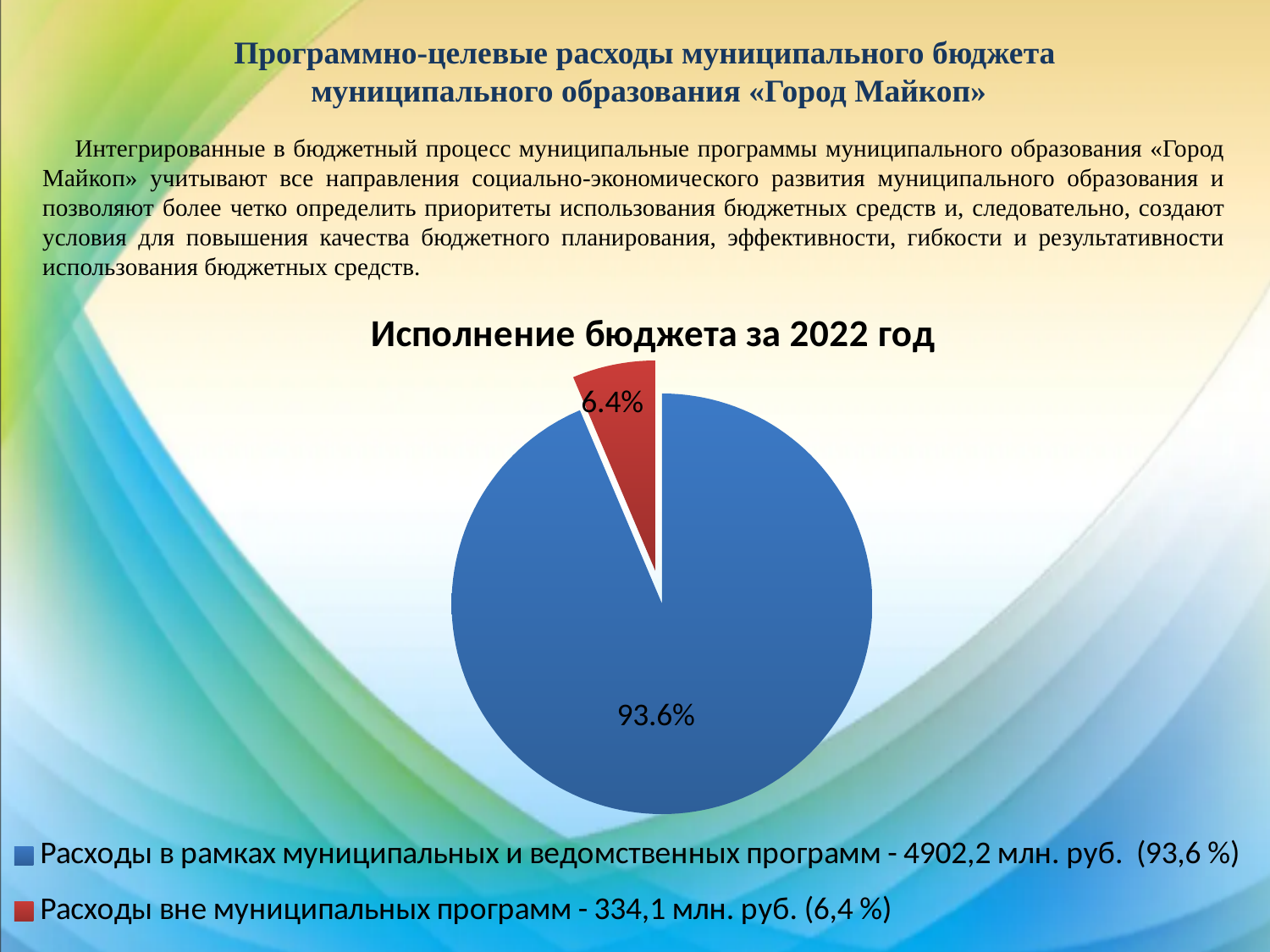
Which category has the largest slice of the pie? Расходы в рамках муниципальных и ведомственных программ What colour is the slice for 'Расходы вне муниципальных программ'? red How many slices does the pie chart have? 2 What amount in млн. руб. does the legend give for 'Расходы вне муниципальных программ'? 334,1 млн. руб. What share of the pie is labelled for 'Расходы вне муниципальных программ'? 6.4% What is the title of the chart? Исполнение бюджета за 2022 год Which category has the smallest slice of the pie? Расходы вне муниципальных программ What kind of chart is shown on the slide? pie chart Which is larger: the share for 'Расходы вне муниципальных программ' or the share for 'Расходы в рамках муниципальных и ведомственных программ'? Расходы в рамках муниципальных и ведомственных программ What is the difference in percentage points between the two slices of the pie? 87.2 What share of the pie is labelled for 'Расходы в рамках муниципальных и ведомственных программ'? 93.6% What amount in млн. руб. does the legend give for 'Расходы в рамках муниципальных и ведомственных программ'? 4902,2 млн. руб.